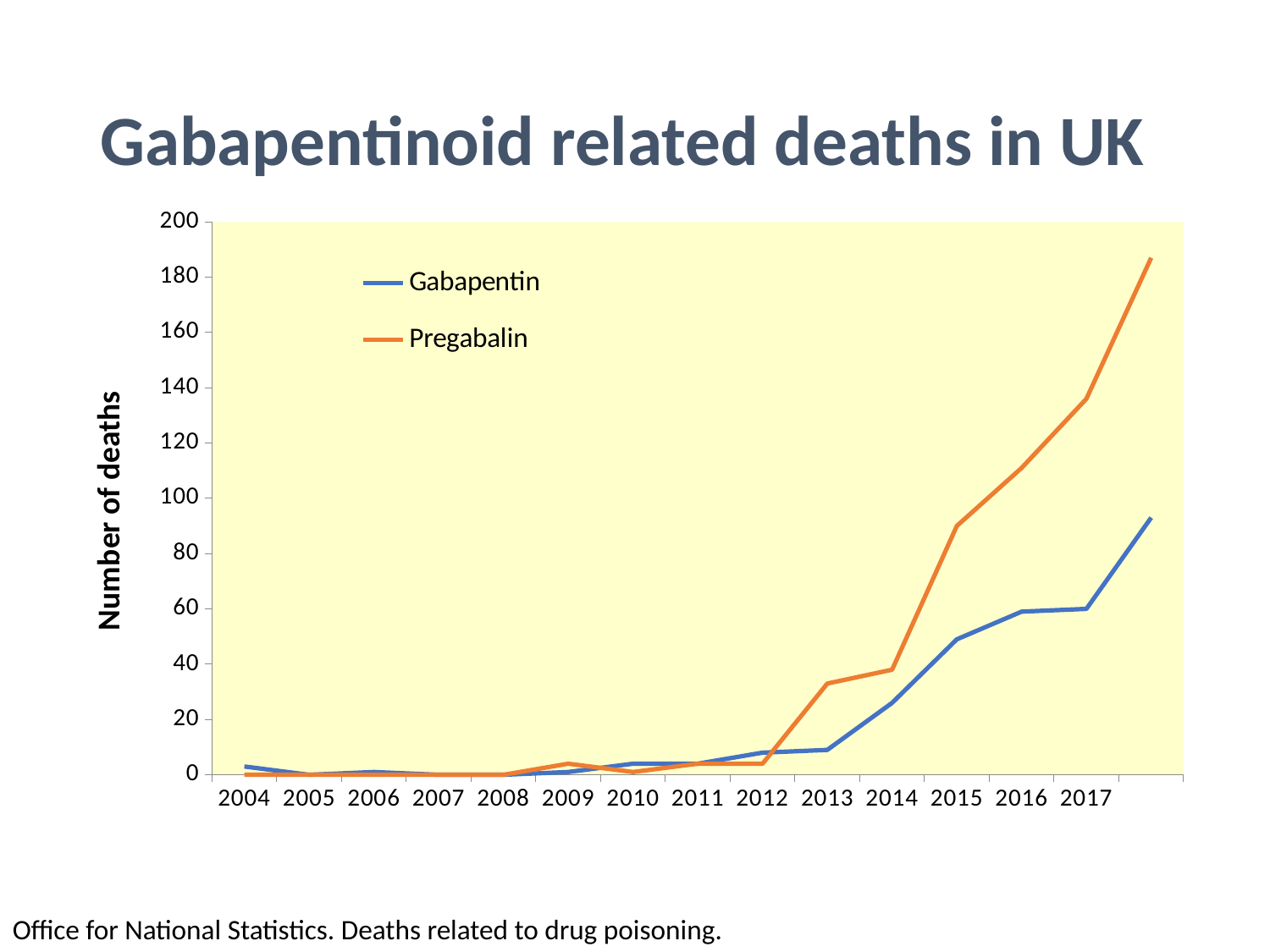
In 2017, which series has the larger value, Gabapentin or Pregabalin? Pregabalin Is the value for Pregabalin in 2015 greater or less than 80? greater What kind of chart is shown on the slide? line chart What is the label on the vertical axis? Number of deaths How many series does the legend list? 2 Is the value for Pregabalin in 2013 greater or less than 20? greater What is the title of the chart? Gabapentinoid related deaths in UK Is the value for Pregabalin in 2017 greater or less than 120? greater Do the Pregabalin values generally rise or fall from 2012 onwards? rise Which series reaches the highest number of deaths on the chart? Pregabalin